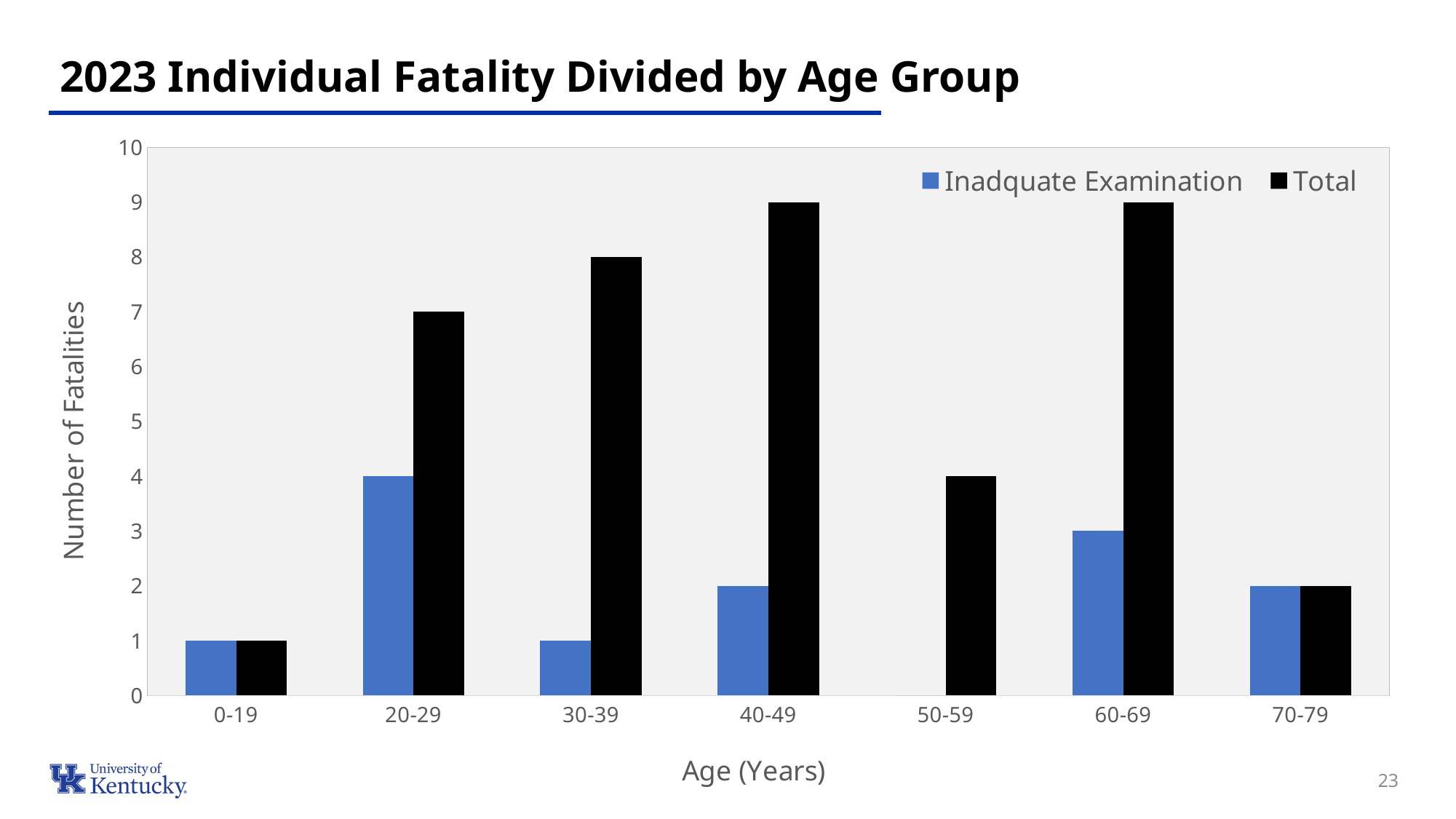
Is the Total value for the 40-49 age group greater or less than 5? greater Which age group has the lowest Total value? 0-19 What is the Total number of fatalities for the 30-39 age group? 8 What is the title of the chart? 2023 Individual Fatality Divided by Age Group What is the difference between the Total and Inadquate Examination values for the 20-29 age group? 3 How many series does the legend list? 2 What type of chart is shown on the slide? Bar chart Which is larger for the 60-69 age group, the Total value or the Inadquate Examination value? Total What is the Total value for the 50-59 age group? 4 What is the Inadquate Examination value for the 20-29 age group? 4 How many age groups are shown on the x axis? 7 Which age group has the highest Inadquate Examination value? 20-29